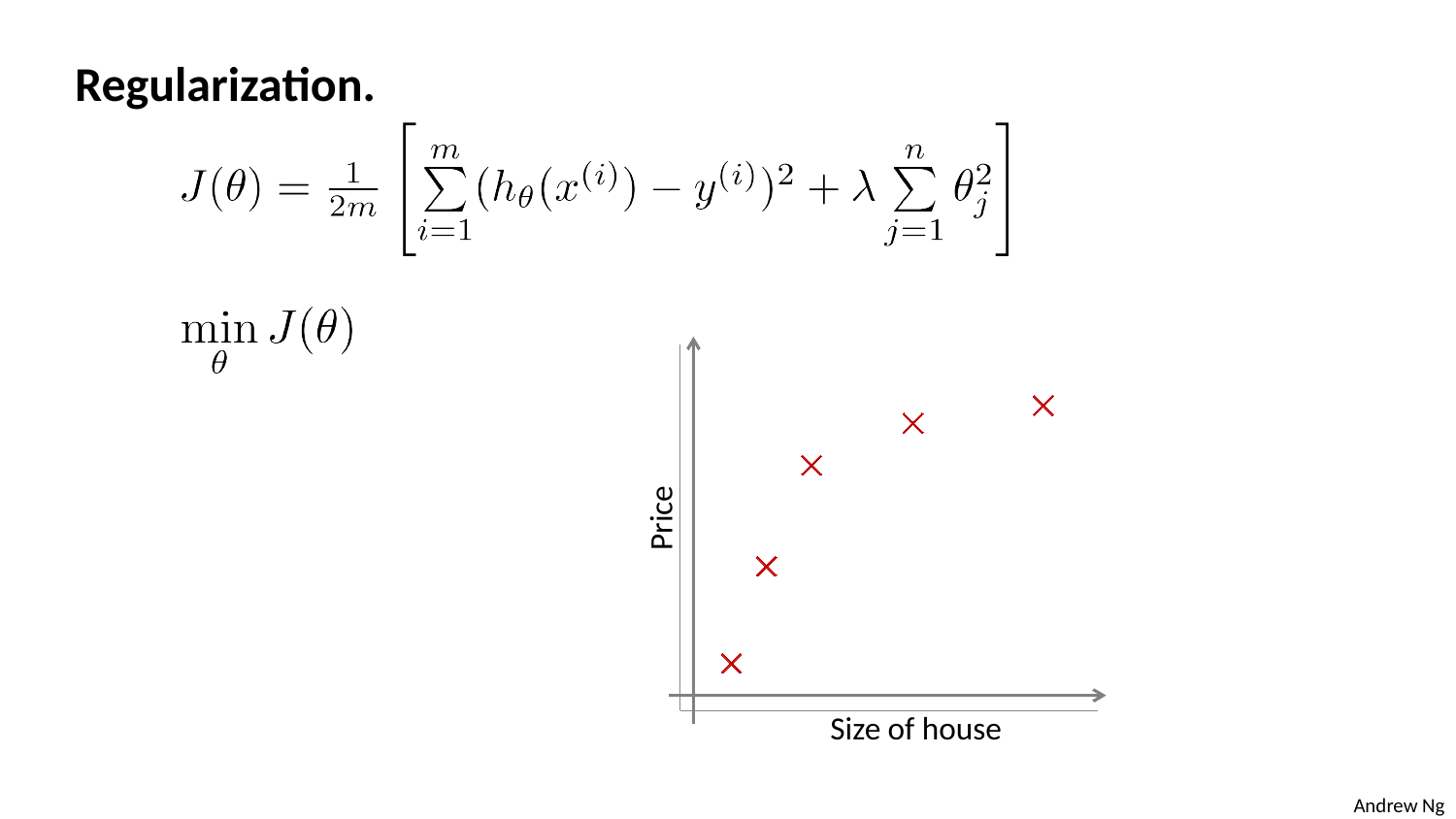
What kind of chart is shown on the slide? scatter plot How many data points are plotted on the chart? 5 What is the label of the x axis of the chart? Size of house What is the label of the y axis of the chart? Price Do the plotted values rise or fall as size of house increases along the x axis? rise